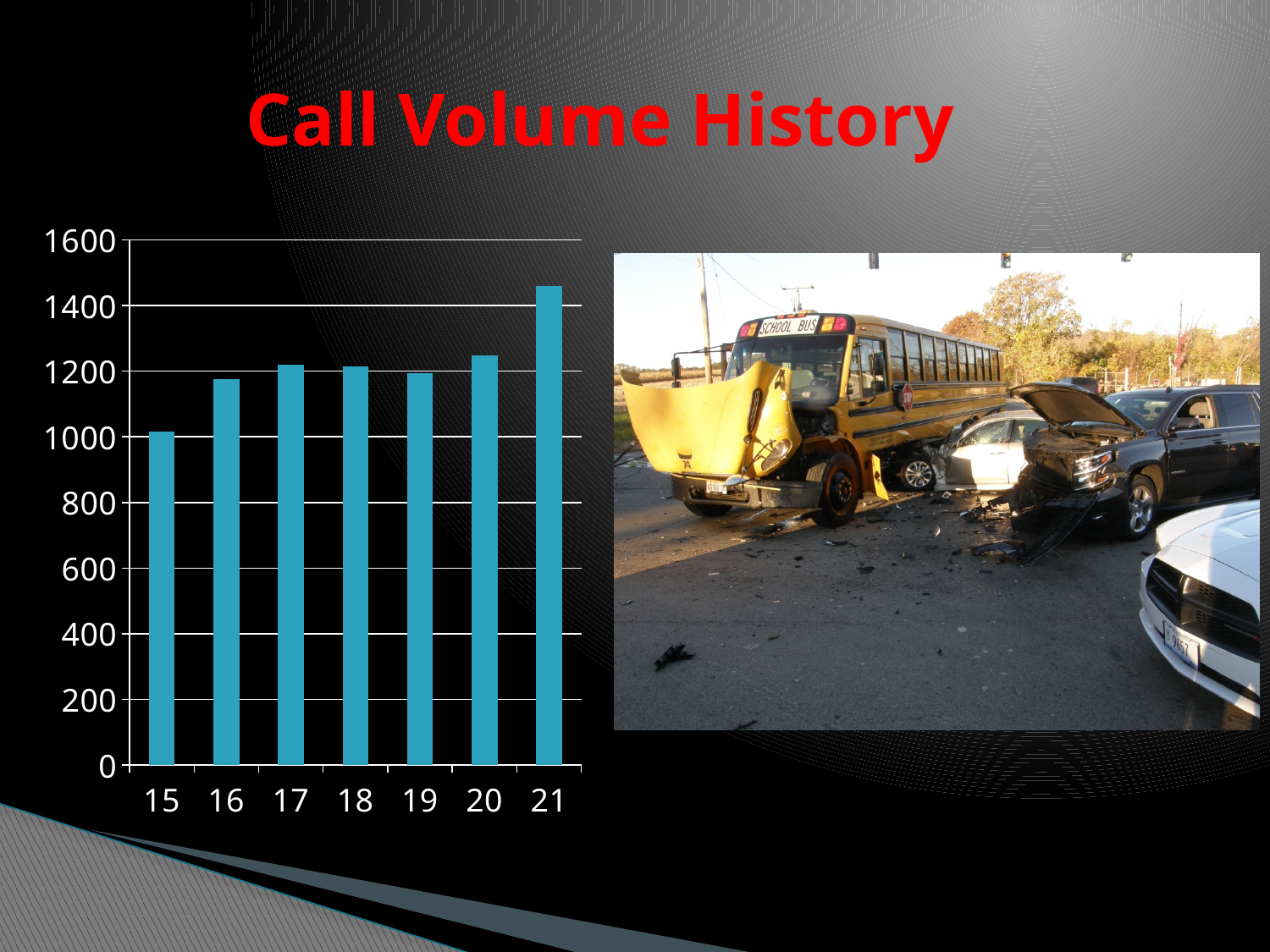
Is the value for 16 greater or less than 1200? less Is the value for 15 greater or less than 1200? less What kind of chart is shown on the slide? bar chart What is the title of the slide containing the chart? Call Volume History Is the value for 20 greater or less than 1200? greater Which is larger, the value for 21 or the value for 15? 21 What colour are the bars in the chart? blue Does the value rise or fall from 20 to 21? rise How many categories are plotted on the x axis of the chart? 7 Which category has the lowest bar in the chart? 15 Which category has the highest bar in the chart? 21